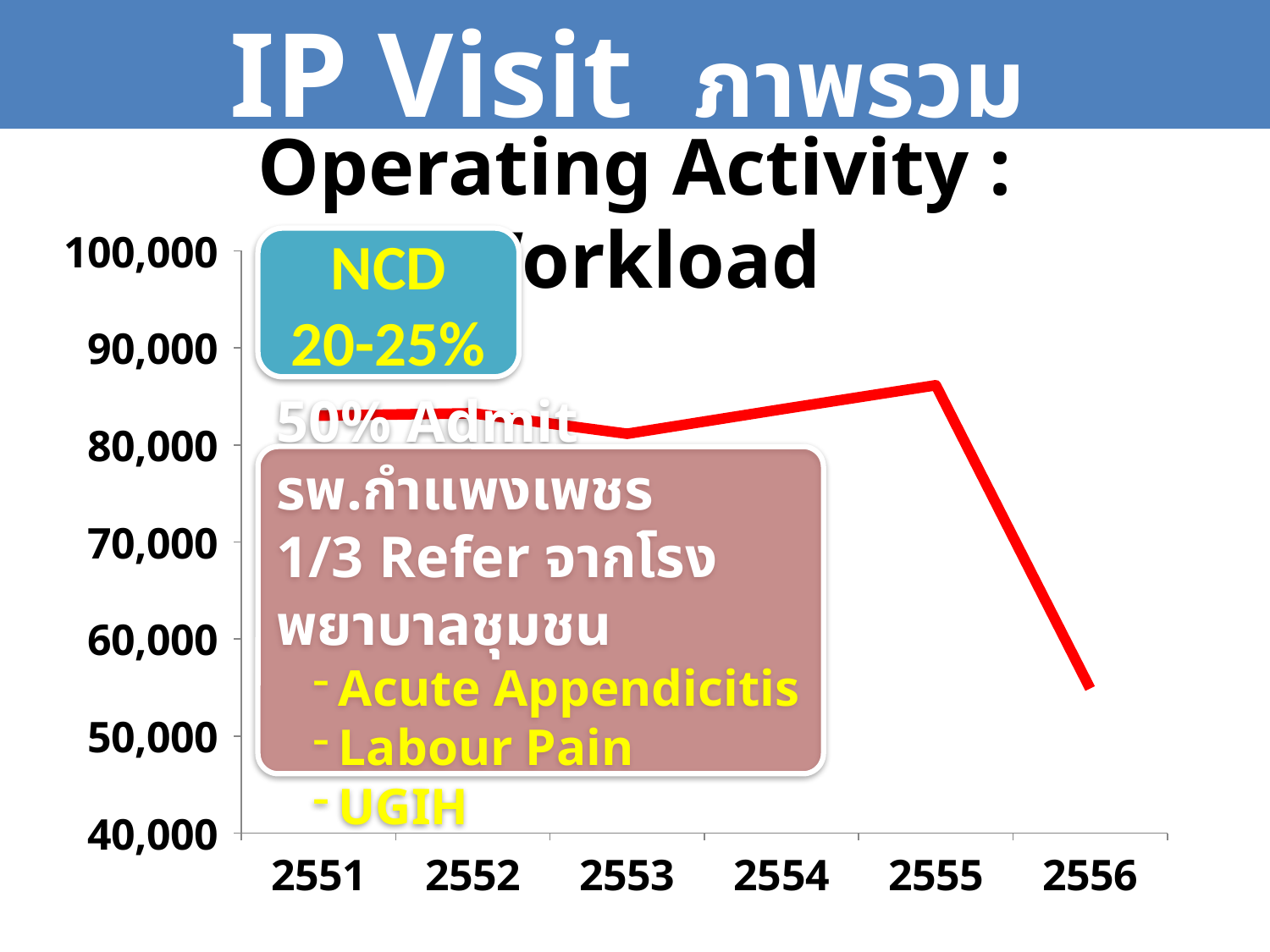
How many years are shown on the x axis of the chart? 6 Which year has the highest value on the chart? 2555 Which is larger, the value for 2555 or the value for 2553? 2555 Is the value for 2556 greater or less than 60,000? less Does the value rise or fall from 2555 to 2556? fall Is the value for 2555 greater or less than 80,000? greater What is the highest value shown on the y axis of the chart? 100,000 Which is larger, the value for 2554 or the value for 2556? 2554 What kind of chart is shown on the slide? line chart Is the value for 2554 greater or less than 80,000? greater Which year has the lowest value on the chart? 2556